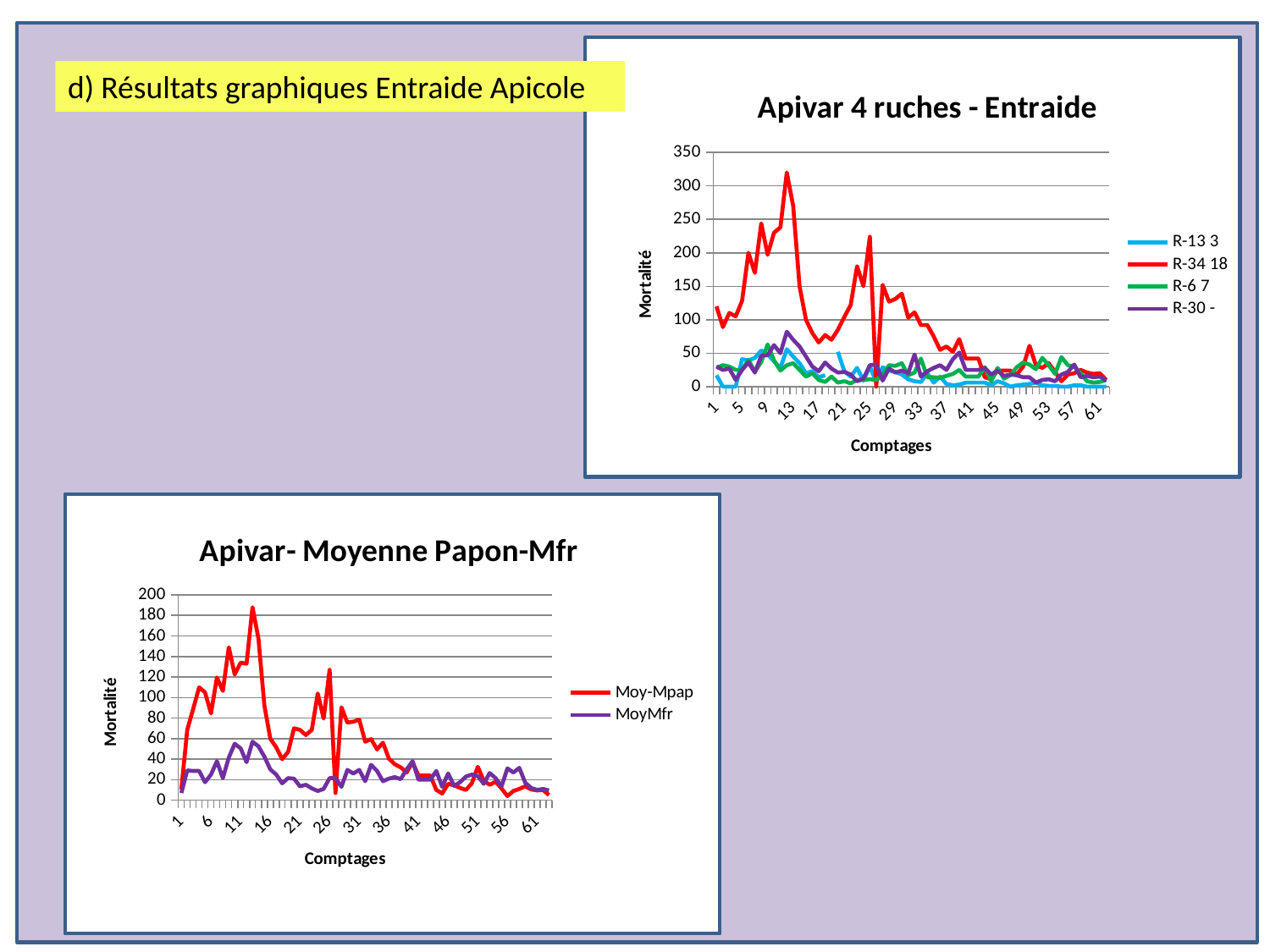
What kind of chart is the "Apivar 4 ruches - Entraide" chart? line chart In the "Apivar 4 ruches - Entraide" chart, is the peak value of the R-34 18 series greater or less than 300? greater In the "Apivar- Moyenne Papon-Mfr" chart, is the highest value of the MoyMfr series greater or less than 80? less How many series does the legend of the "Apivar- Moyenne Papon-Mfr" chart list? 2 In the "Apivar- Moyenne Papon-Mfr" chart, which series reaches the higher peak value, Moy-Mpap or MoyMfr? Moy-Mpap In the "Apivar- Moyenne Papon-Mfr" chart, is the peak value of the Moy-Mpap series greater or less than 160? greater In the "Apivar 4 ruches - Entraide" chart, do the R-34 18 values rise or fall between count 13 and count 61? fall In the "Apivar 4 ruches - Entraide" chart, which series reaches the highest mortality value? R-34 18 How many series does the legend of the "Apivar 4 ruches - Entraide" chart list? 4 What is the label of the vertical axis on the "Apivar 4 ruches - Entraide" chart? Mortalité What kind of chart is the "Apivar- Moyenne Papon-Mfr" chart? line chart